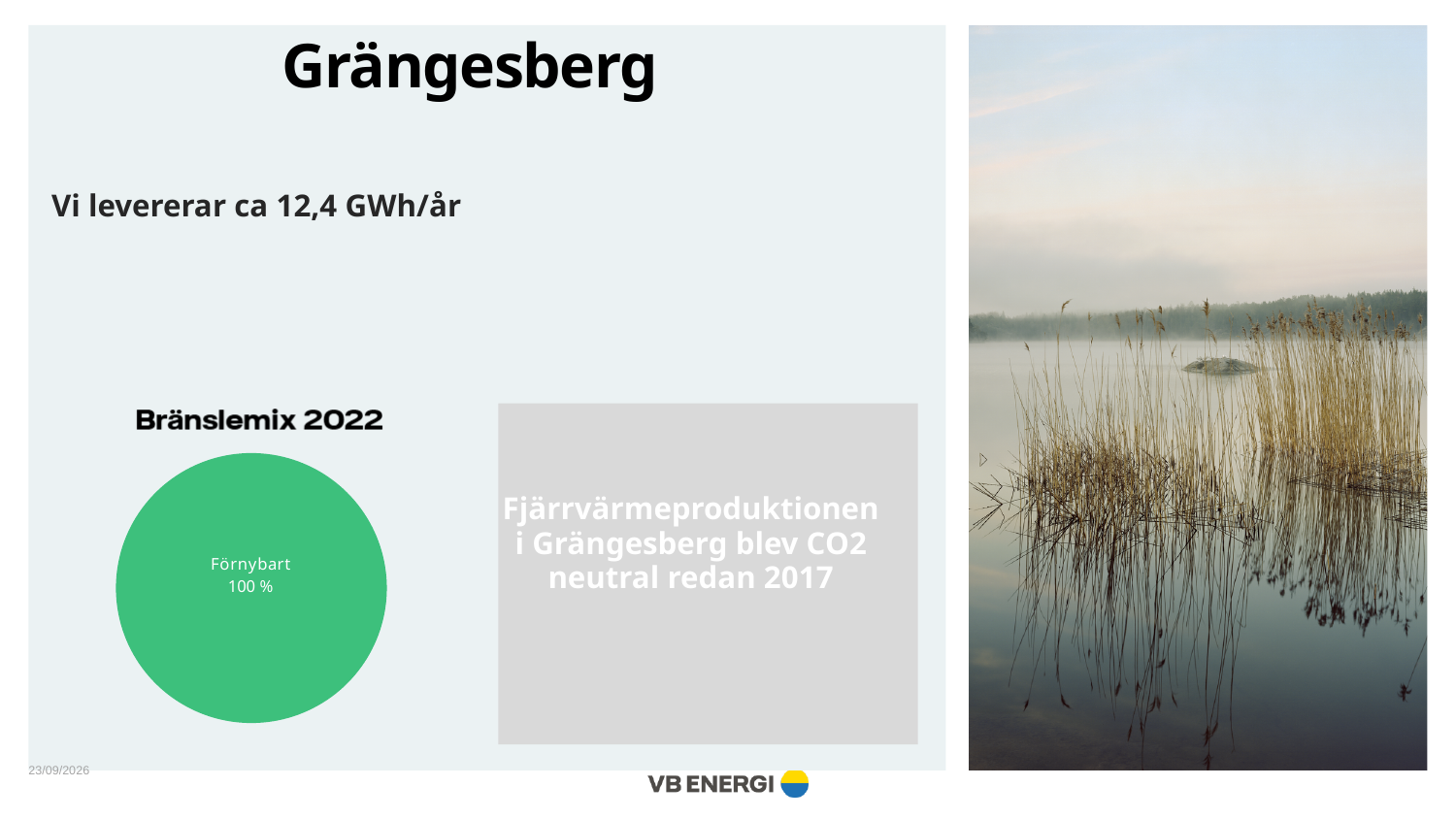
What is the value shown for Förnybart in the pie chart? 100 % What kind of chart is shown under the title 'Bränslemix 2022'? pie chart Which category is the largest in the pie chart? Förnybart Is the value for Förnybart in the pie chart greater or less than 50 %? greater How many slices does the pie chart have? 1 What colour is the Förnybart slice in the pie chart? green What is the title of the chart on the slide? Bränslemix 2022 What share of the pie chart does Förnybart represent? 100 %